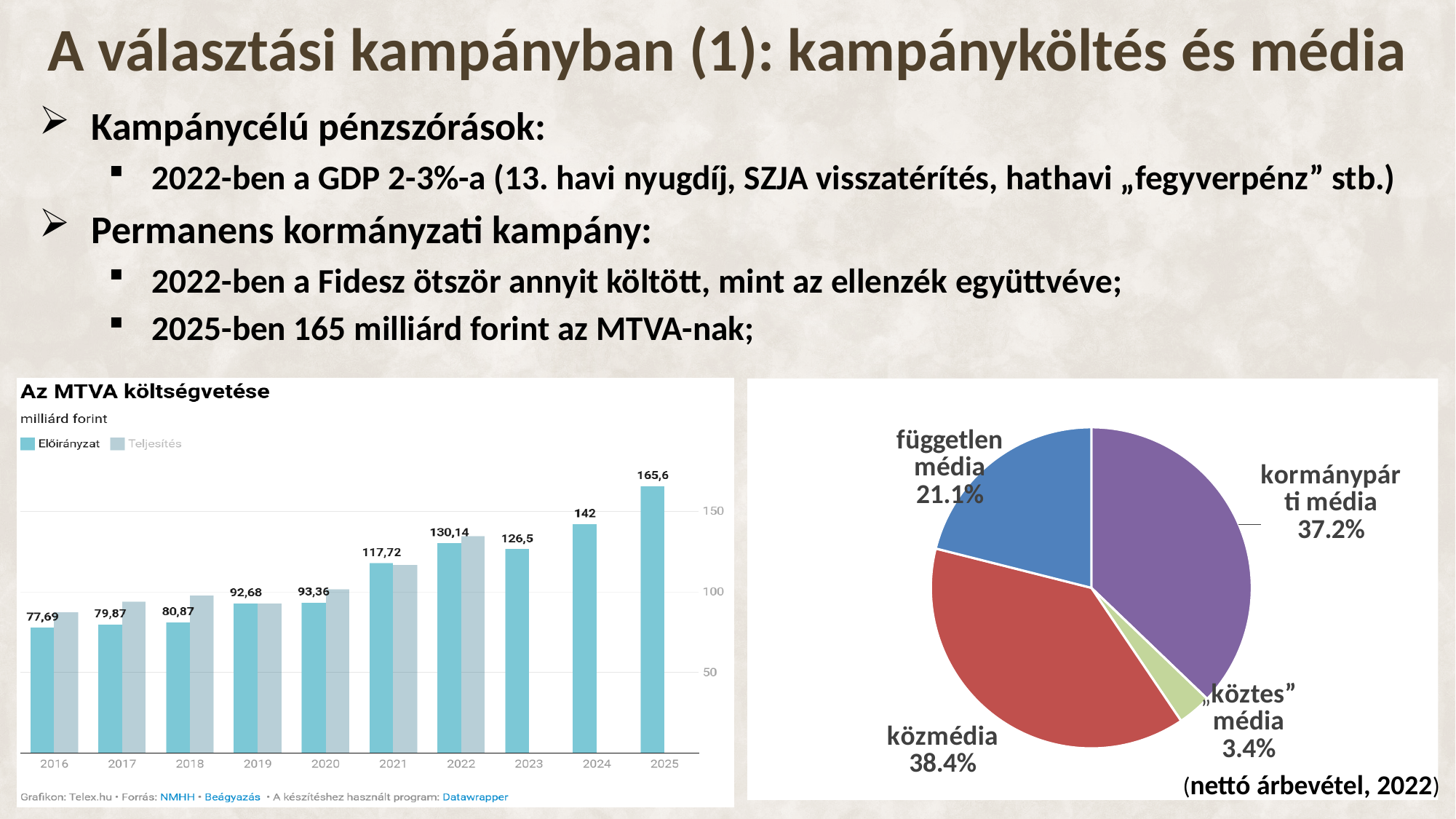
In the chart titled "Az MTVA költségvetése", which year has the highest Előirányzat value? 2025 What kind of chart is the one on the right side of the slide? pie chart In the pie chart on the right, what share does közmédia have? 38.4% In the chart titled "Az MTVA költségvetése", is the Előirányzat value for 2022 larger or smaller than the value for 2023? larger In the chart titled "Az MTVA költségvetése", is the Teljesítés value for 2021 greater or less than 100? greater In the chart titled "Az MTVA költségvetése", how many series does the legend list? 2 In the chart titled "Az MTVA költségvetése", how many years are shown on the x axis? 10 In the chart titled "Az MTVA költségvetése", what is the Előirányzat value for 2022? 130,14 In the chart titled "Az MTVA költségvetése", what is the Előirányzat value for 2025? 165,6 In the chart titled "Az MTVA költségvetése", what is the Előirányzat value for 2016? 77,69 In the chart titled "Az MTVA költségvetése", what is the difference between the Előirányzat values for 2025 and 2024? 23,6 In the chart titled "Az MTVA költségvetése", which year has the lowest Előirányzat value? 2016